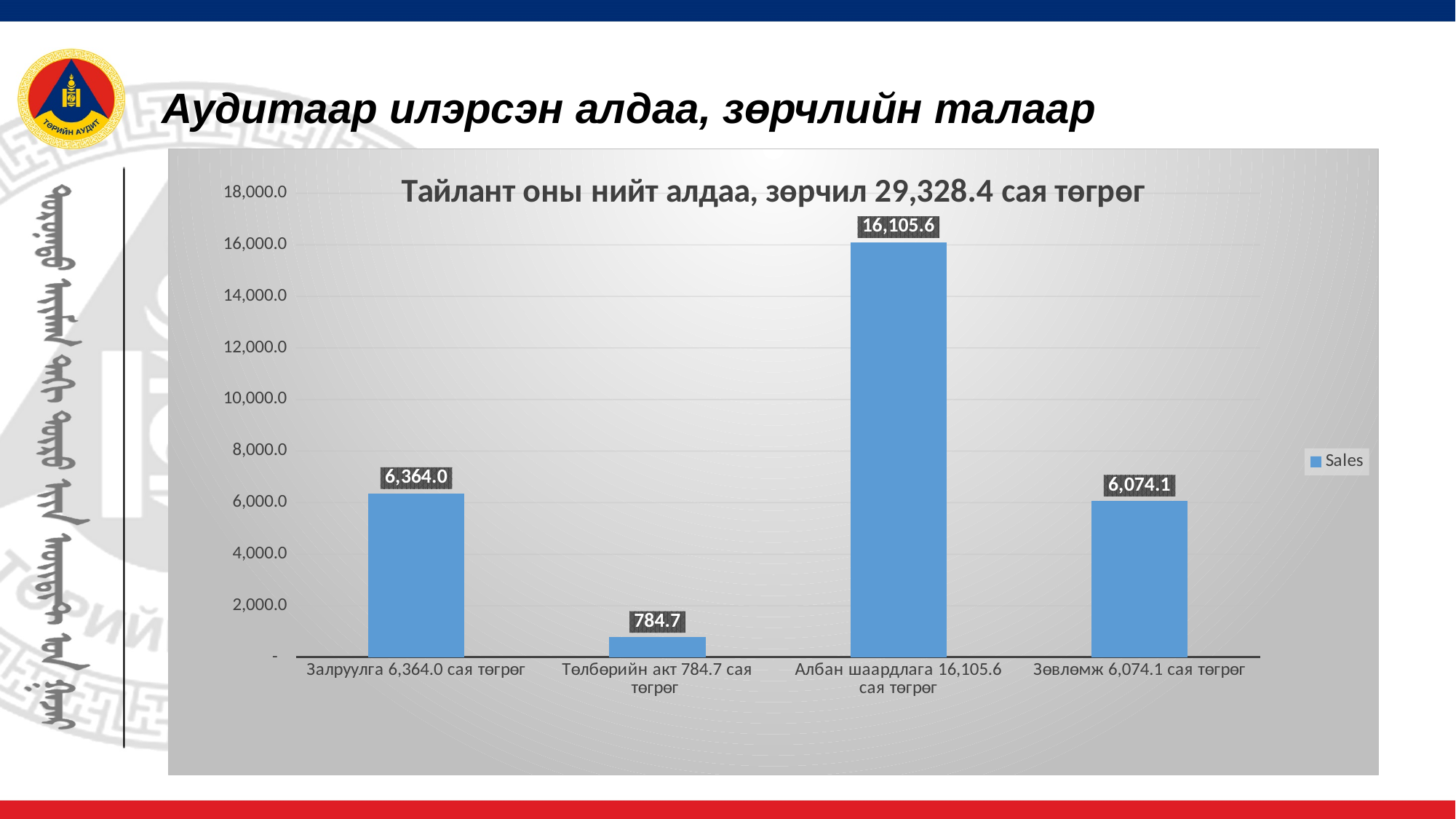
What is the difference between the values for Залруулга and Зөвлөмж? 289.9 What is the difference between the values for Албан шаардлага and Төлбөрийн акт? 15,320.9 What is the value for Төлбөрийн акт? 784.7 How many categories are shown in the chart? 4 What is the value for Залруулга? 6,364.0 Which category has the lowest value? Төлбөрийн акт What is the value for Албан шаардлага? 16,105.6 Which category has the highest value? Албан шаардлага What series name does the legend show? Sales What is the value for Зөвлөмж? 6,074.1 What kind of chart is shown on the slide? Bar chart Which is larger, the value for Залруулга or the value for Зөвлөмж? Залруулга